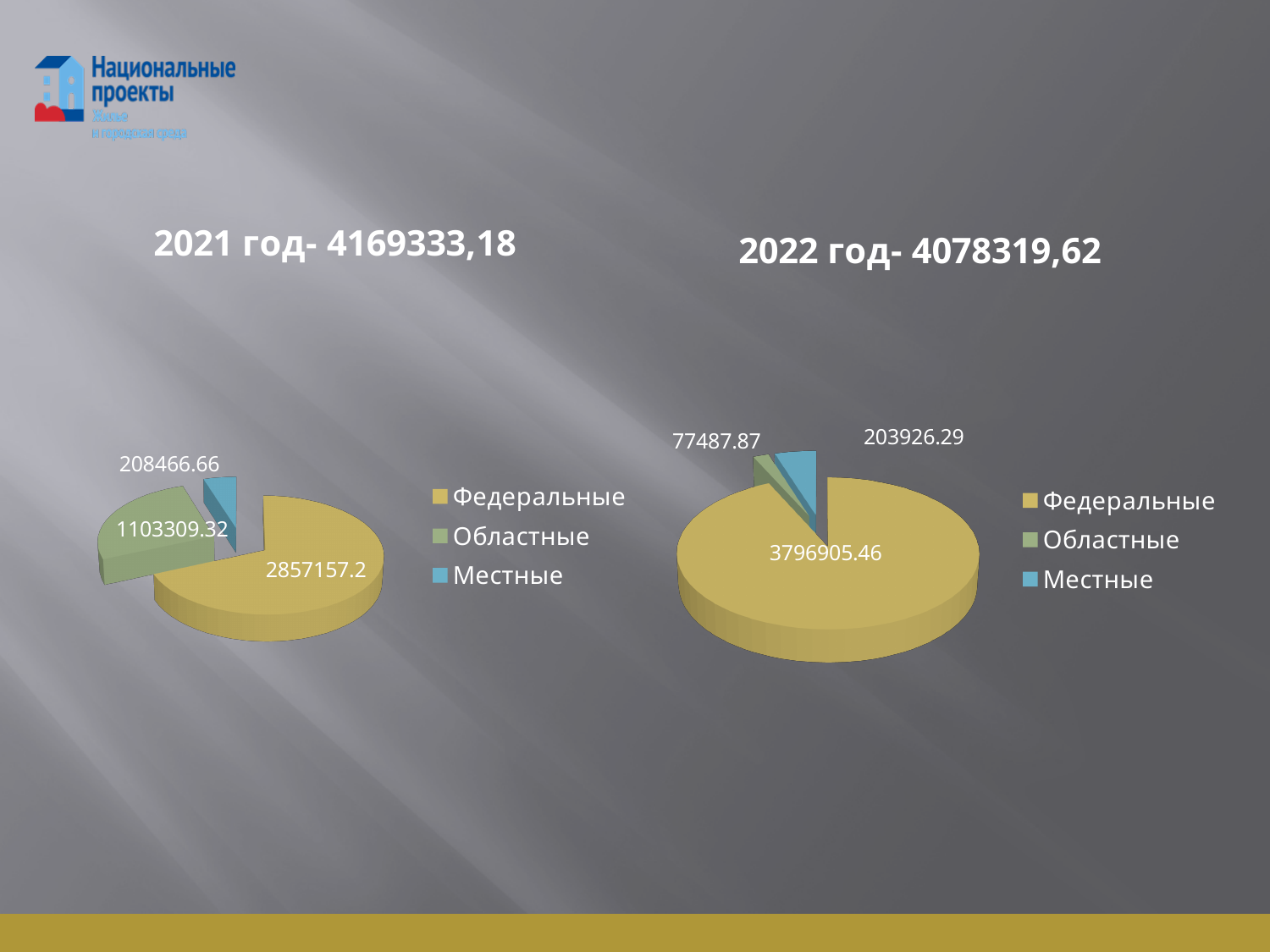
In the 2021 год pie chart, what is the value for Областные? 1103309.32 In the 2022 год pie chart, what is the value for Местные? 203926.29 How many entries does the legend of the 2022 год chart list? 3 In the 2021 год pie chart, what is the value for Местные? 208466.66 In the 2022 год pie chart, what is the value for Федеральные? 3796905.46 In the 2021 год pie chart, what is the value for Федеральные? 2857157.2 In the 2022 год pie chart, which category has the smallest slice? Областные In the 2022 год pie chart, which is larger, Областные or Местные? Местные In the 2021 год pie chart, which category has the largest slice? Федеральные What type of chart is used for the 2021 год data? Pie chart In the 2022 год pie chart, what is the value for Областные? 77487.87 In the 2021 год pie chart, what is the difference between the Федеральные and Областные values? 1753847.88